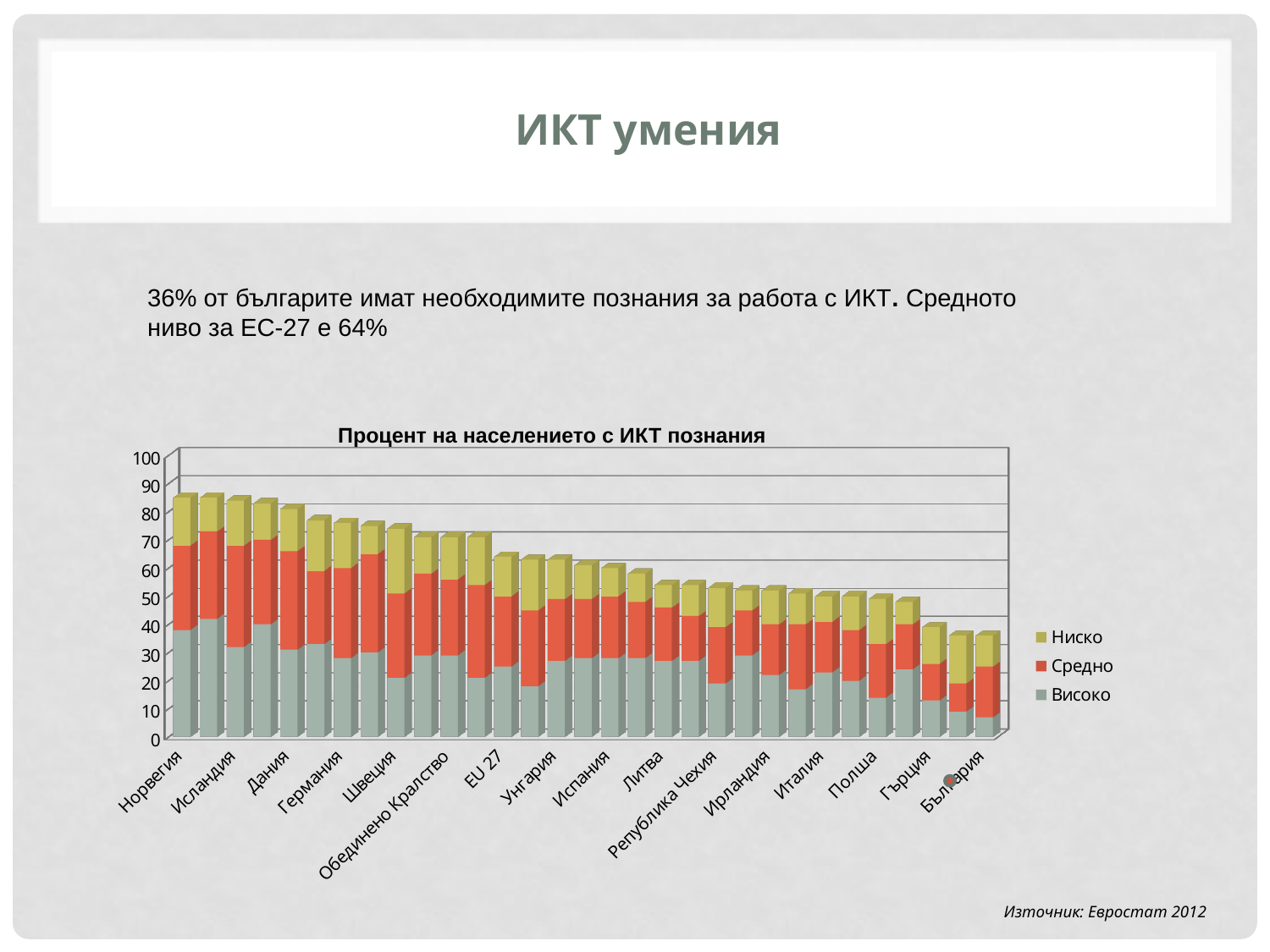
Is the total value for EU 27 greater or less than 60? greater Which has the larger total value, Дания or Полша? Дания How many series does the legend of the chart list? 3 Do the total bar heights rise or fall moving from left to right along the x axis? Fall What are the three series listed in the chart legend? Ниско, Средно, Високо Is the total value for България greater or less than 40? less According to the slide text, what percentage of Bulgarians have the necessary ICT skills? 36% What is the title of the chart? Процент на населението с ИКТ познания What kind of chart is shown on the slide? Stacked bar chart Is the Високо value for България greater or less than 10? less Which has the larger total value, Норвегия or България? Норвегия